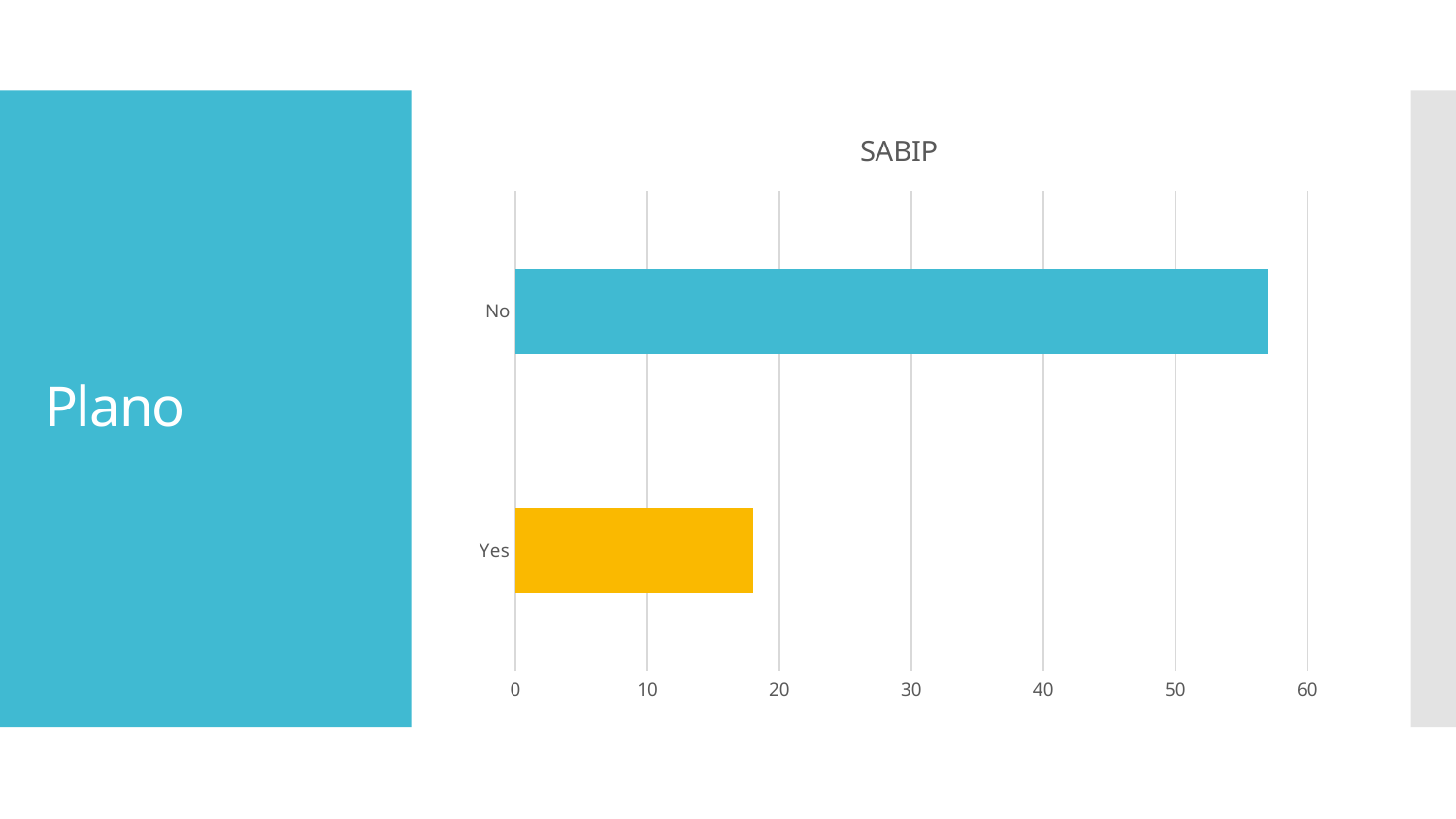
Which category has the lowest value? Yes Is the value for Yes greater or less than 10? greater How many categories are plotted in the chart? 2 Is the value for No greater or less than 60? less Is the value for No greater or less than 50? greater Which is larger, the value for No or the value for Yes? No Which category has the highest value? No What colour is the bar for Yes? yellow What kind of chart is shown on the slide? bar chart What is the title of the chart? SABIP